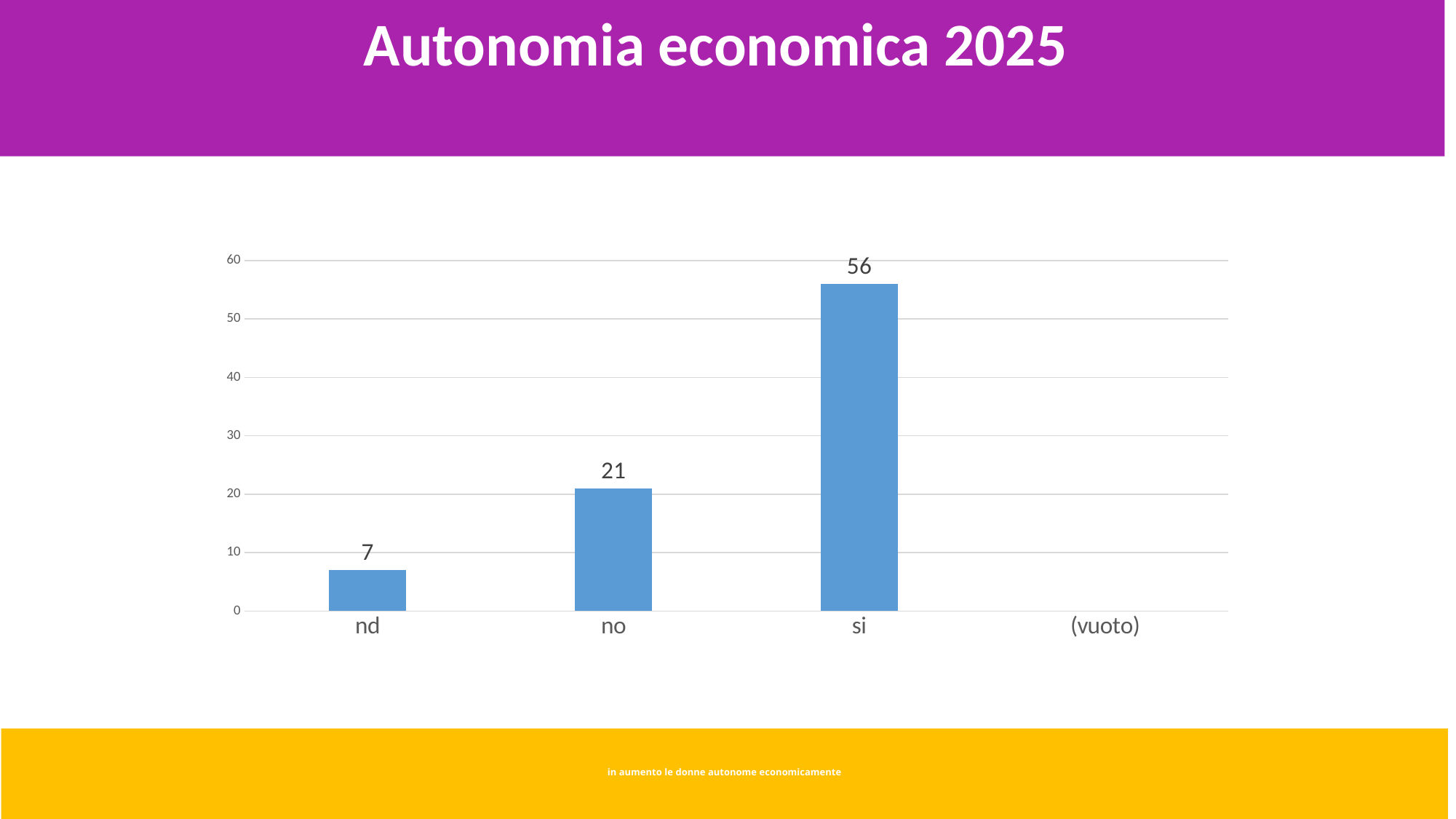
Which category has the highest value? si What is the value for the category 'si'? 56 What is the difference between the values for 'no' and 'nd'? 14 What kind of chart is shown on the slide? bar chart What is the value for the category 'nd'? 7 What is the value for the category 'no'? 21 What is the title of the slide? Autonomia economica 2025 What is the difference between the values for 'si' and 'no'? 35 Which category with a visible bar has the lowest value? nd How many categories are shown on the x axis? 4 Is the value for 'si' greater or less than 50? greater Which is larger, the value for 'no' or the value for 'nd'? no